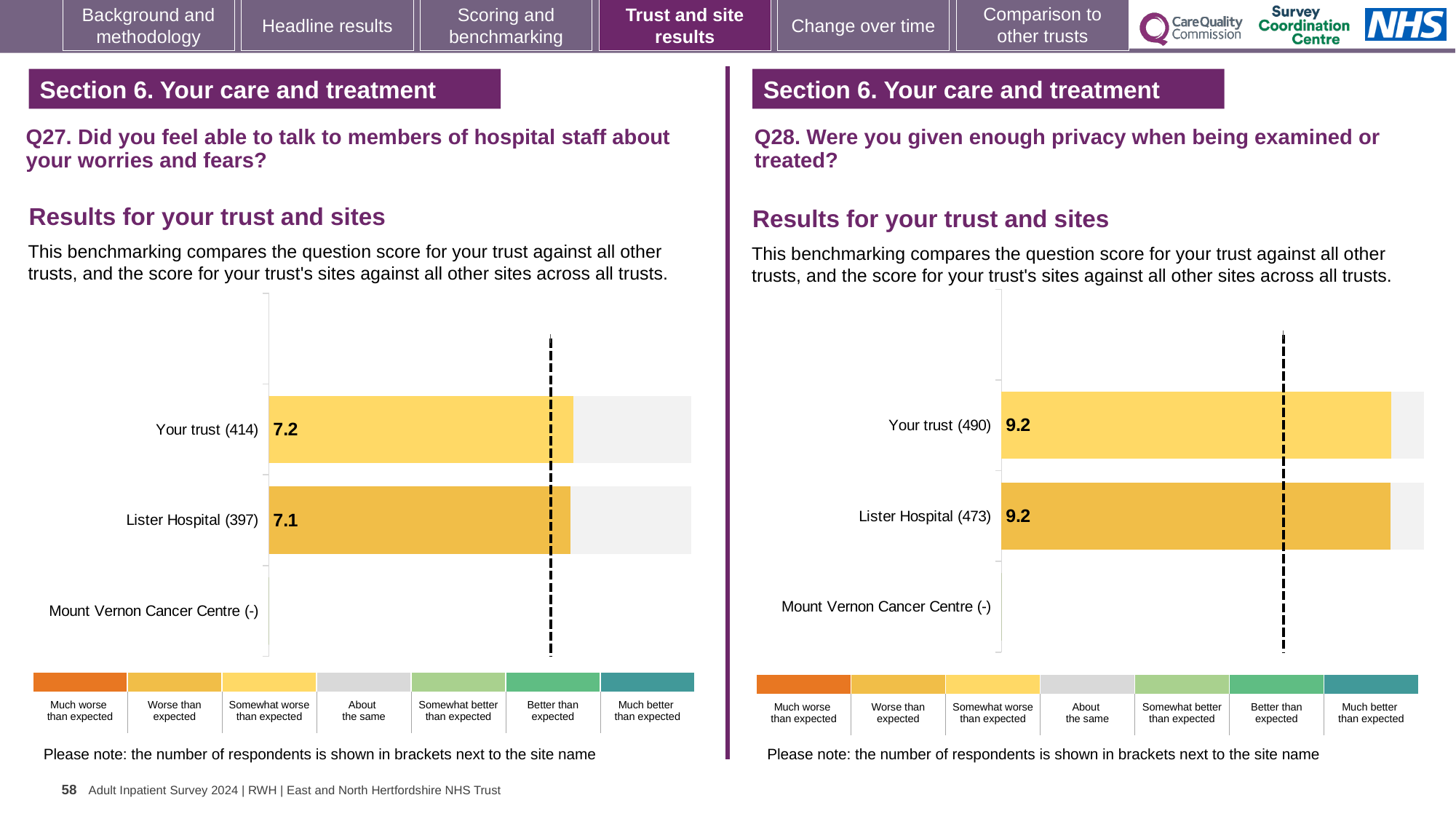
In the Q28 chart on the right, what is the score for Lister Hospital? 9.2 In the Q27 chart on the left, what is the difference between the scores for Your trust and Lister Hospital? 0.1 In the Q27 chart on the left, which category has no score shown? Mount Vernon Cancer Centre In the Q27 chart on the left, what is the score for Your trust? 7.2 In the Q28 chart on the right, what is the score for Your trust? 9.2 In the Q27 chart on the left, what is the score for Lister Hospital? 7.1 In the Q28 chart on the right, how many respondents are shown for Lister Hospital? 473 What kind of chart is used in the Q28 chart on the right? Bar chart In the Q27 chart on the left, how many site or trust categories are listed on the vertical axis? 3 In the Q28 chart on the right, what is the difference between the scores for Your trust and Lister Hospital? 0 In the Q27 chart on the left, how many respondents are shown for Your trust? 414 In the Q28 chart on the right, what colour is the bar for Lister Hospital? Orange